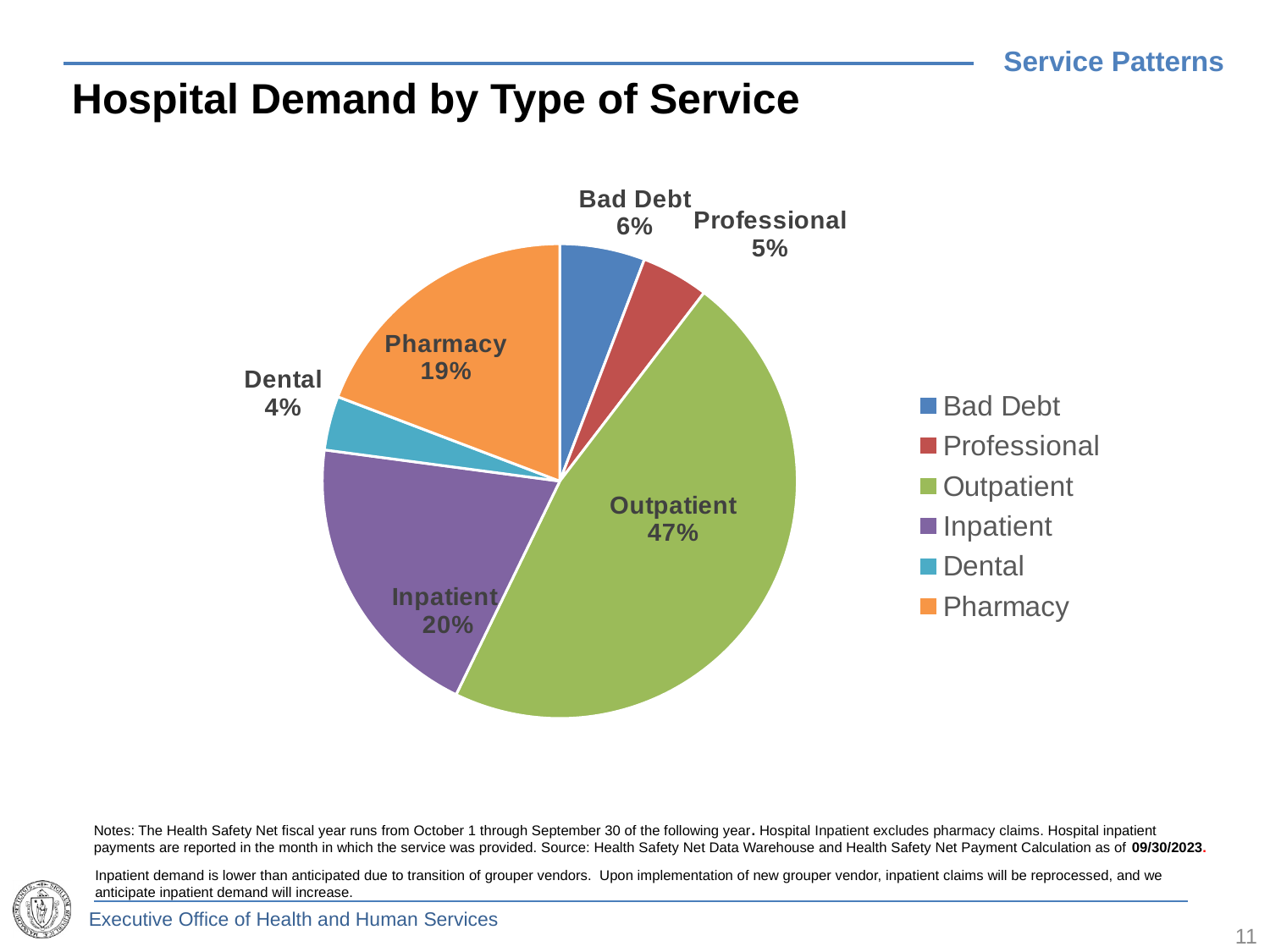
What share of hospital demand is Bad Debt? 6% What share of hospital demand is Pharmacy? 19% What type of chart is shown on the slide? pie chart Which type of service has the largest share of hospital demand? Outpatient What share of hospital demand is Outpatient? 47% Which has a larger share, Inpatient or Pharmacy? Inpatient What is the difference in percentage points between the Outpatient and Inpatient shares? 27 How many types of service are shown in the pie chart? 6 What colour is the Outpatient slice? green Which type of service has the smallest share of hospital demand? Dental What share of hospital demand is Dental? 4% What is the title of the chart? Hospital Demand by Type of Service